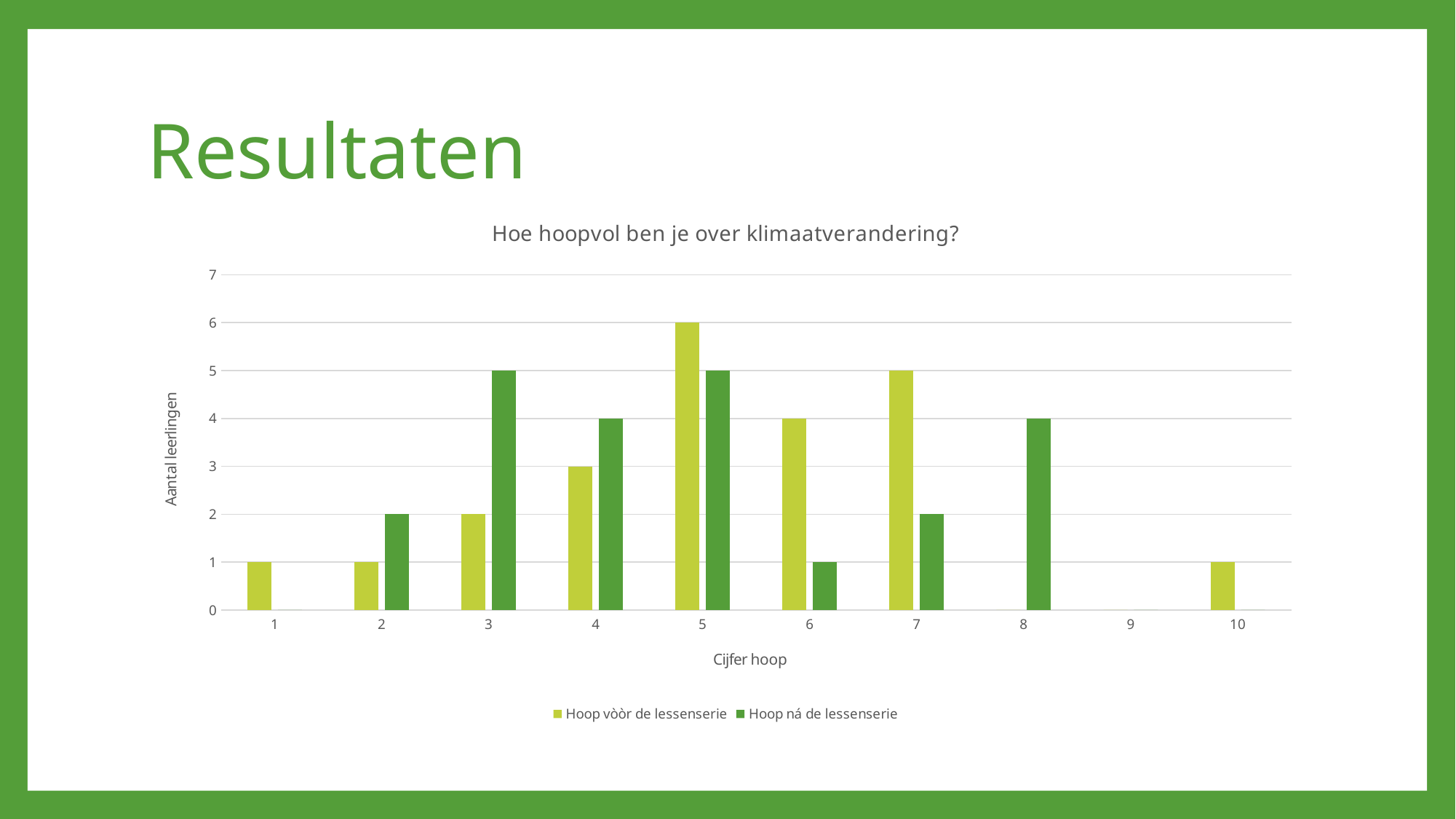
How many categories are shown on the x axis (Cijfer hoop)? 10 For a hope score of 3, which series has the larger value: Hoop vòòr de lessenserie or Hoop ná de lessenserie? Hoop ná de lessenserie How many students gave a hope score of 5 before the lesson series (Hoop vòòr de lessenserie)? 6 How many series does the legend list? 2 How many students gave a hope score of 3 after the lesson series (Hoop ná de lessenserie)? 5 What is the difference between the Hoop vòòr de lessenserie and Hoop ná de lessenserie values for a hope score of 7? 3 How many students gave a hope score of 8 after the lesson series (Hoop ná de lessenserie)? 4 What is the label of the y axis? Aantal leerlingen What kind of chart is shown on the slide? Bar chart What is the title of the chart? Hoe hoopvol ben je over klimaatverandering? Which hope score has the highest number of students for Hoop vòòr de lessenserie? 5 What is the difference between the Hoop vòòr de lessenserie and Hoop ná de lessenserie values for a hope score of 6? 3